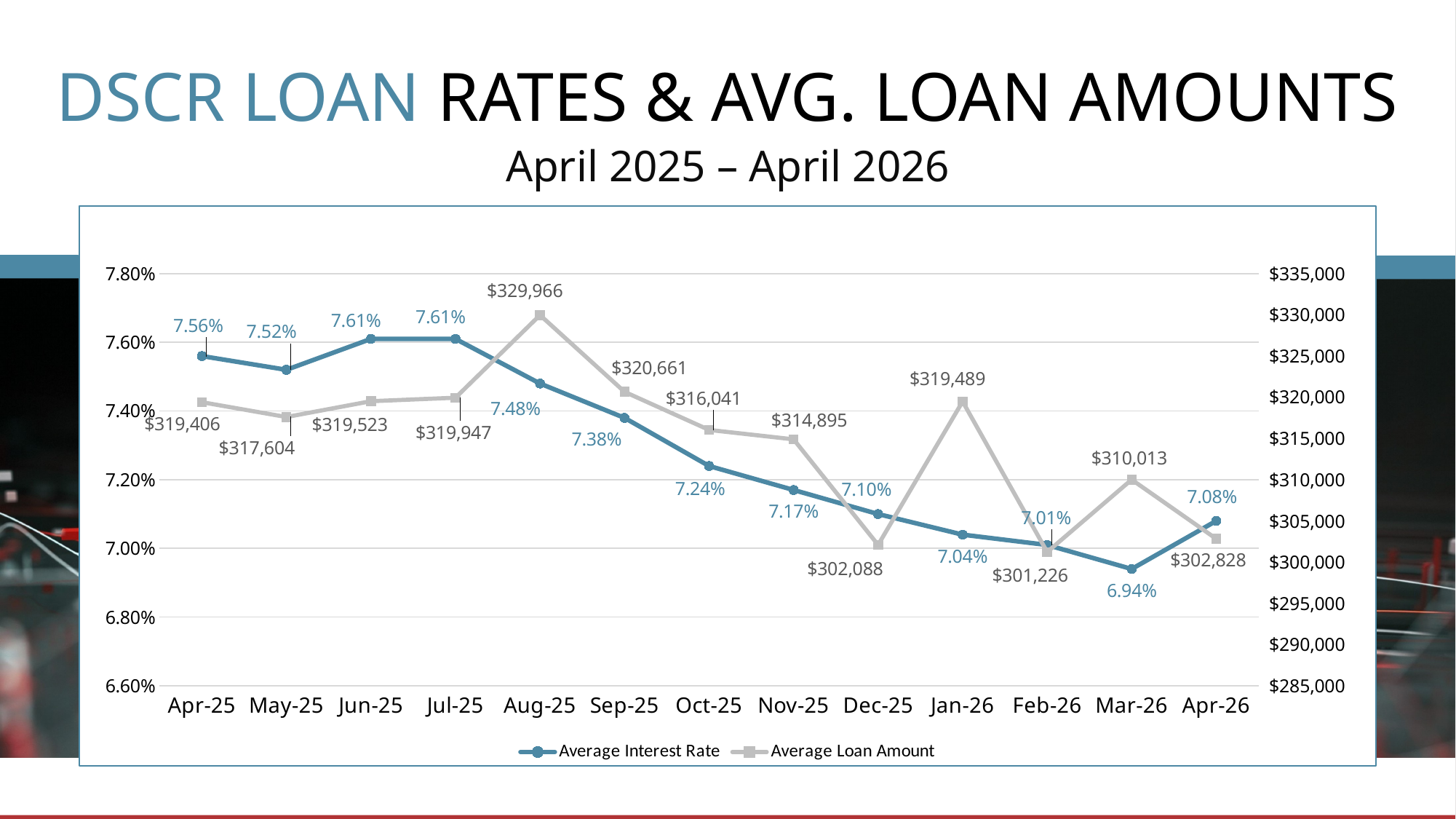
How many months are plotted on the x axis? 13 In which month was the Average Interest Rate lowest? Mar-26 What was the Average Interest Rate in Oct-25? 7.24% Which month had a higher Average Loan Amount, Dec-25 or Mar-26? Mar-26 What was the Average Interest Rate in Apr-26? 7.08% What kind of chart is shown on the slide? Line chart How many series does the legend list? 2 What is the difference between the highest Average Loan Amount (Aug-25) and the lowest (Feb-26)? $28,740 What was the Average Loan Amount in Jan-26? $319,489 In which month was the Average Loan Amount lowest? Feb-26 By how many percentage points did the Average Interest Rate fall from Apr-25 to Apr-26? 0.48 percentage points In which month was the Average Loan Amount highest? Aug-25